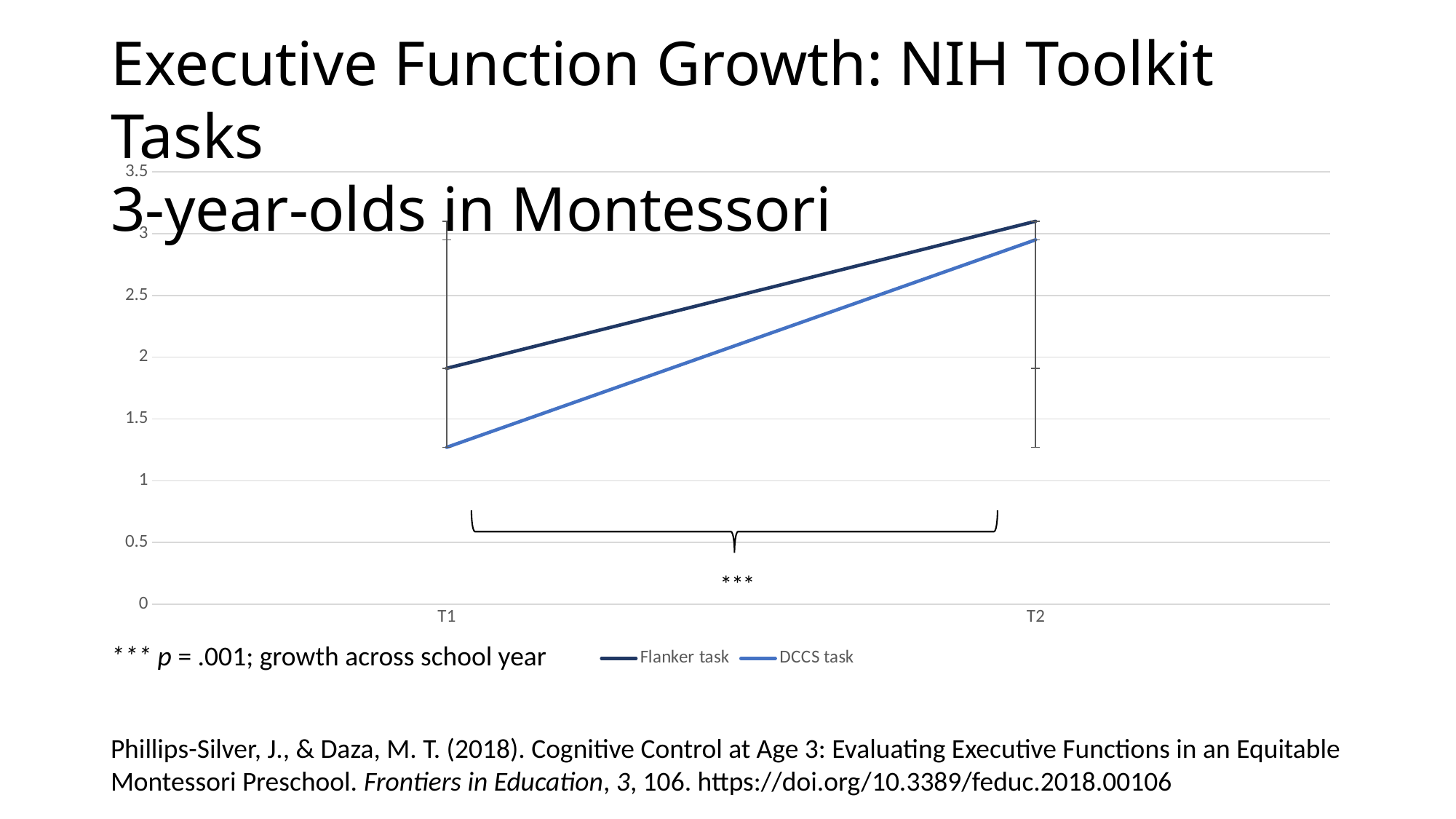
Does the DCCS task line rise or fall from T1 to T2? rise How many series does the legend list? 2 Is the value for the DCCS task at T1 greater or less than 1.5? less What kind of chart is shown on the slide? line chart Is the value for the Flanker task at T2 greater or less than 2.5? greater How many time points are shown on the x axis? 2 What are the labels on the x axis? T1 and T2 Which two series are listed in the legend? Flanker task and DCCS task Is the value for the DCCS task at T2 greater or less than 2.5? greater At T1, which series has the higher value, Flanker task or DCCS task? Flanker task Does the Flanker task line rise or fall from T1 to T2? rise